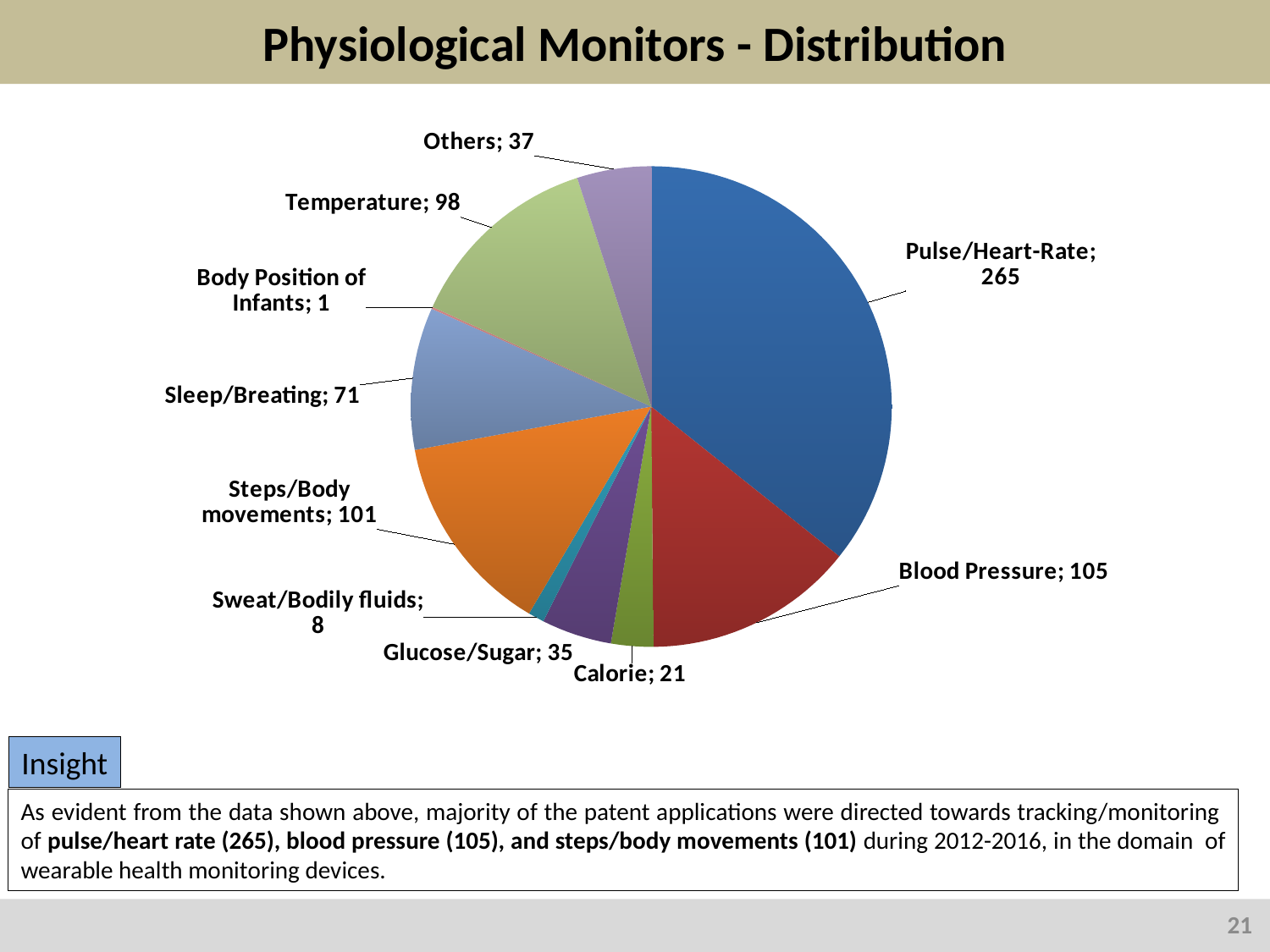
Which category has the smallest slice in the pie chart? Body Position of Infants Which category has the largest slice in the pie chart? Pulse/Heart-Rate What is the value for Steps/Body movements in the pie chart? 101 What is the difference between the values for Temperature and Sleep/Breating? 27 What is the value for Pulse/Heart-Rate in the pie chart? 265 How many categories are shown in the pie chart? 10 What is the title of the slide containing the chart? Physiological Monitors - Distribution What is the value for Sweat/Bodily fluids in the pie chart? 8 Which is larger, the value for Glucose/Sugar or the value for Calorie? Glucose/Sugar Which is larger, the value for Others or the value for Temperature? Temperature What kind of chart is shown on the slide? Pie chart What is the difference between the values for Pulse/Heart-Rate and Blood Pressure? 160